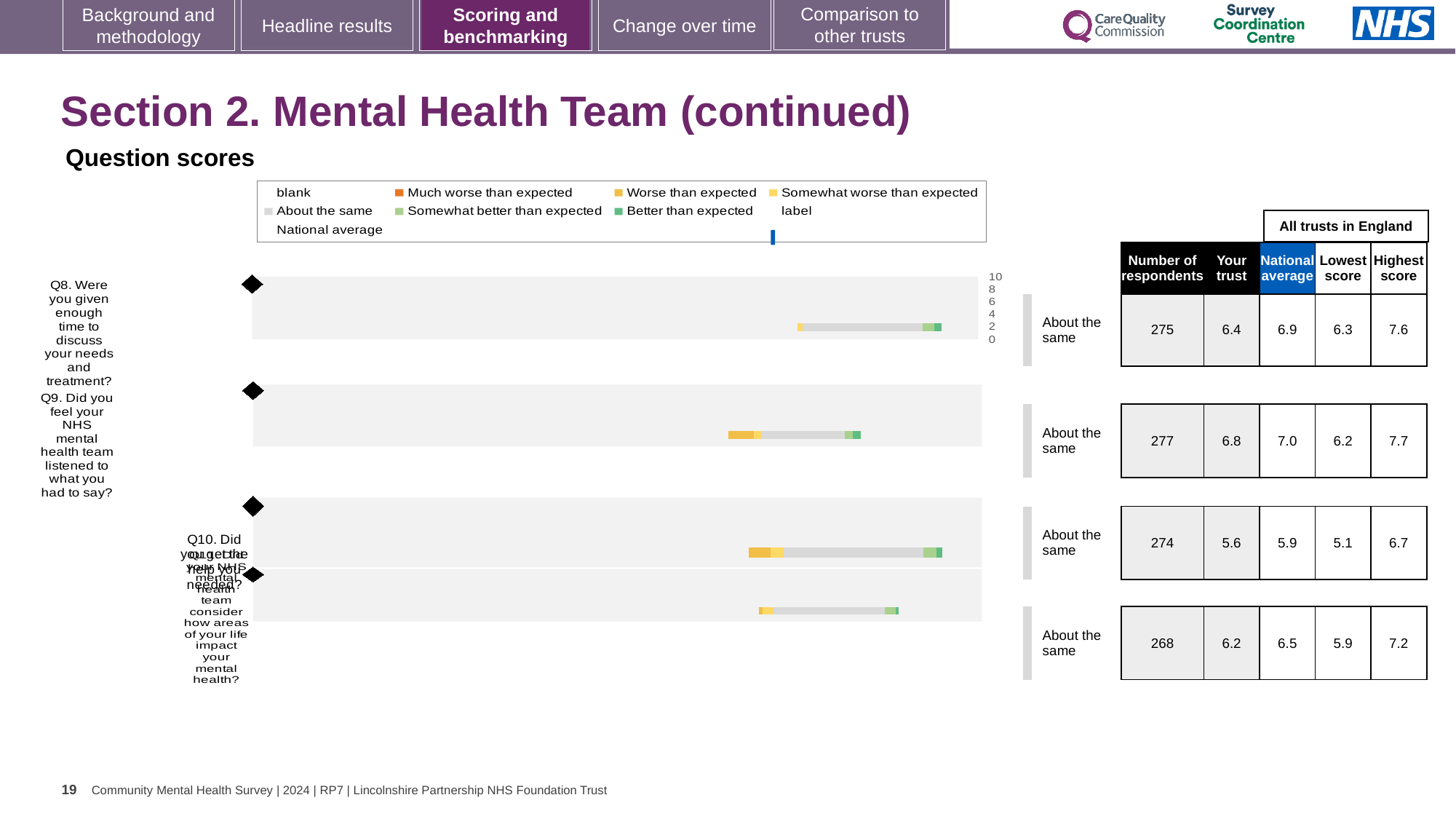
What is the national average score for Q9 (Did you feel your NHS mental health team listened to what you had to say?)? 7.0 What benchmark category is shown for Q8 next to the chart? About the same What kind of chart is used to show the question scores on this slide? bar chart How many questions (bars) are plotted in the question scores chart? 4 In the table next to the chart, what is the 'Your trust' score for Q8 (Were you given enough time to discuss your needs and treatment?)? 6.4 What is the difference between the national average and the 'Your trust' score for Q8? 0.5 Which question has the lowest 'Your trust' score in the table? Q10 Which has the larger 'Your trust' score, Q8 or Q9? Q9 How many respondents answered Q10 (Did you get the help you needed?)? 274 Which question has the highest 'Your trust' score in the table? Q9 What is the highest score across all trusts in England for Q10? 6.7 What is the heading above the chart on this slide? Question scores